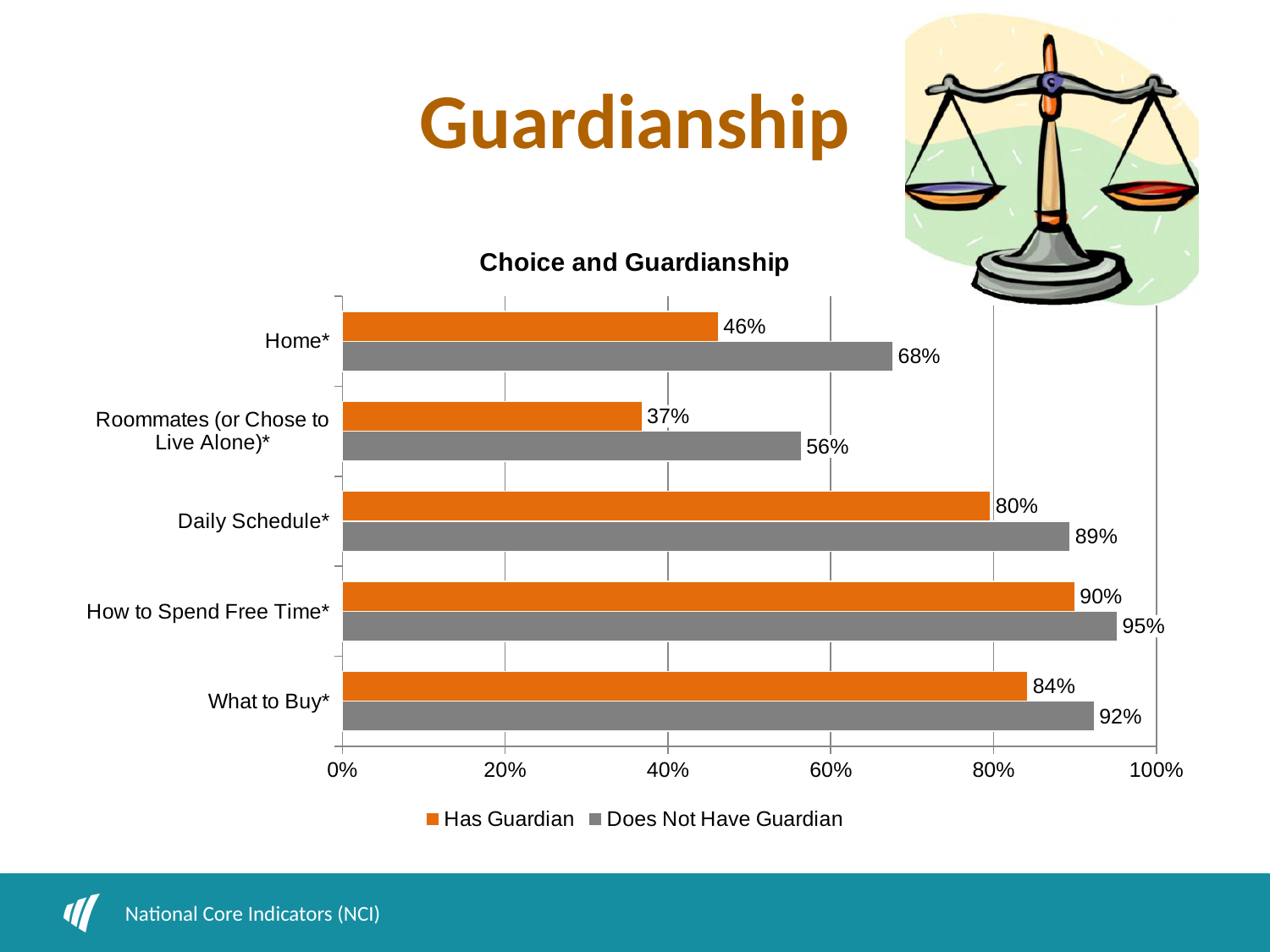
How many series does the legend list? 2 What is the title of the chart? Choice and Guardianship What is the value for Has Guardian for Home*? 46% What is the difference between Does Not Have Guardian and Has Guardian for What to Buy*? 8% What kind of chart is shown? Bar chart Which is larger for Daily Schedule*: Has Guardian or Does Not Have Guardian? Does Not Have Guardian What is the value for Has Guardian for Roommates (or Chose to Live Alone)*? 37% What is the difference between Does Not Have Guardian and Has Guardian for Home*? 22% Which category has the lowest value for Has Guardian? Roommates (or Chose to Live Alone)* How many categories are shown on the chart? 5 Which category has the highest value for Does Not Have Guardian? How to Spend Free Time* What is the value for Does Not Have Guardian for Daily Schedule*? 89%